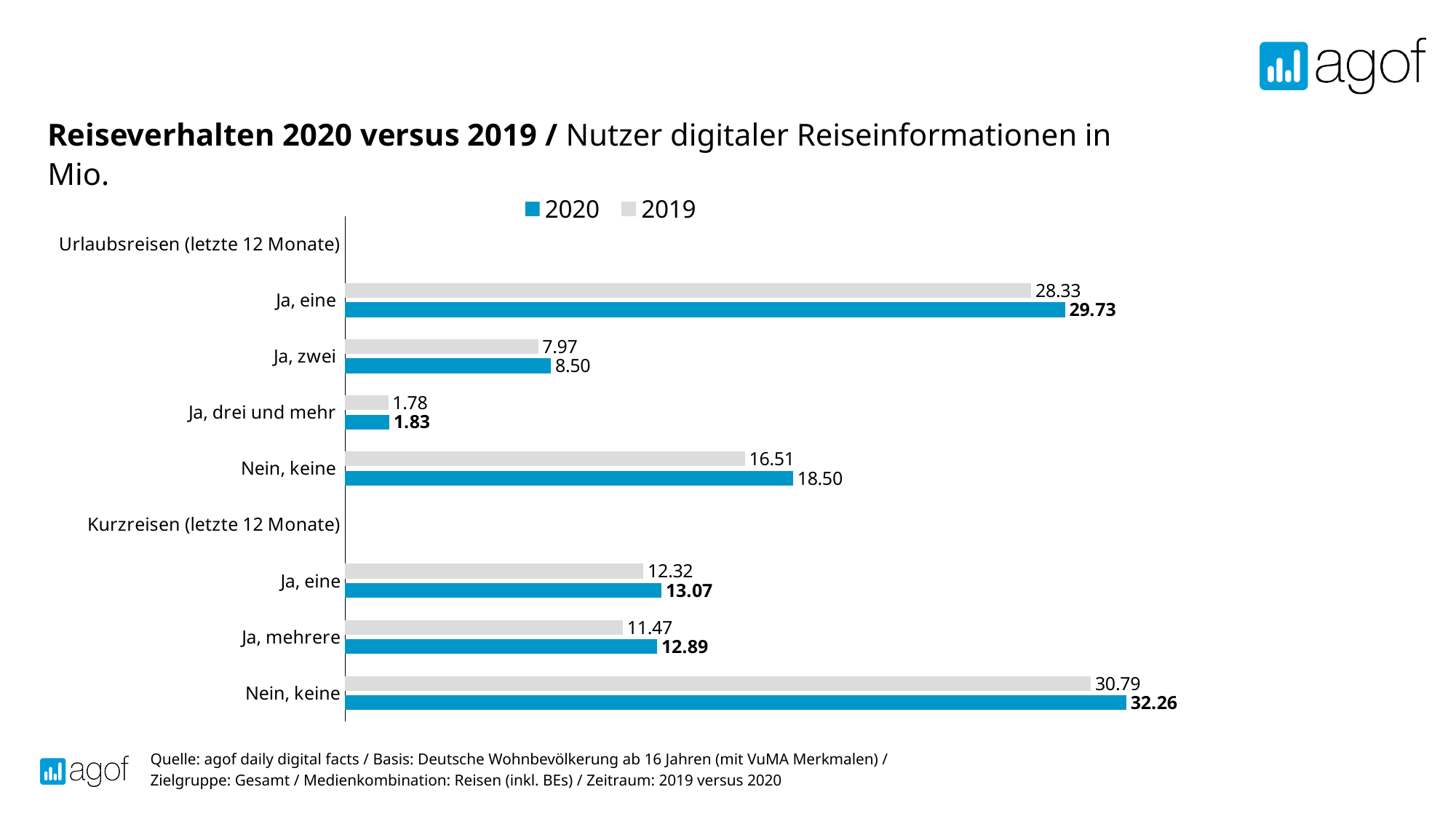
Which is larger for 'Ja, eine' under Kurzreisen (letzte 12 Monate): the 2020 value or the 2019 value? 2020 How many series does the legend list? 2 Which category has the highest 2020 value? Nein, keine (Kurzreisen) What is the difference between the 2020 and 2019 values for 'Ja, mehrere' under Kurzreisen (letzte 12 Monate)? 1.42 What is the 2020 value for 'Ja, eine' under Urlaubsreisen (letzte 12 Monate)? 29.73 What is the 2020 value for 'Nein, keine' under Kurzreisen (letzte 12 Monate)? 32.26 What is the difference between the 2020 and 2019 values for 'Nein, keine' under Urlaubsreisen (letzte 12 Monate)? 1.99 What kind of chart is shown on the slide? bar chart What is the 2019 value for 'Ja, zwei' under Urlaubsreisen (letzte 12 Monate)? 7.97 What is the 2019 value for 'Ja, mehrere' under Kurzreisen (letzte 12 Monate)? 11.47 Which category has the lowest 2019 value? Ja, drei und mehr Which series is shown in blue? 2020